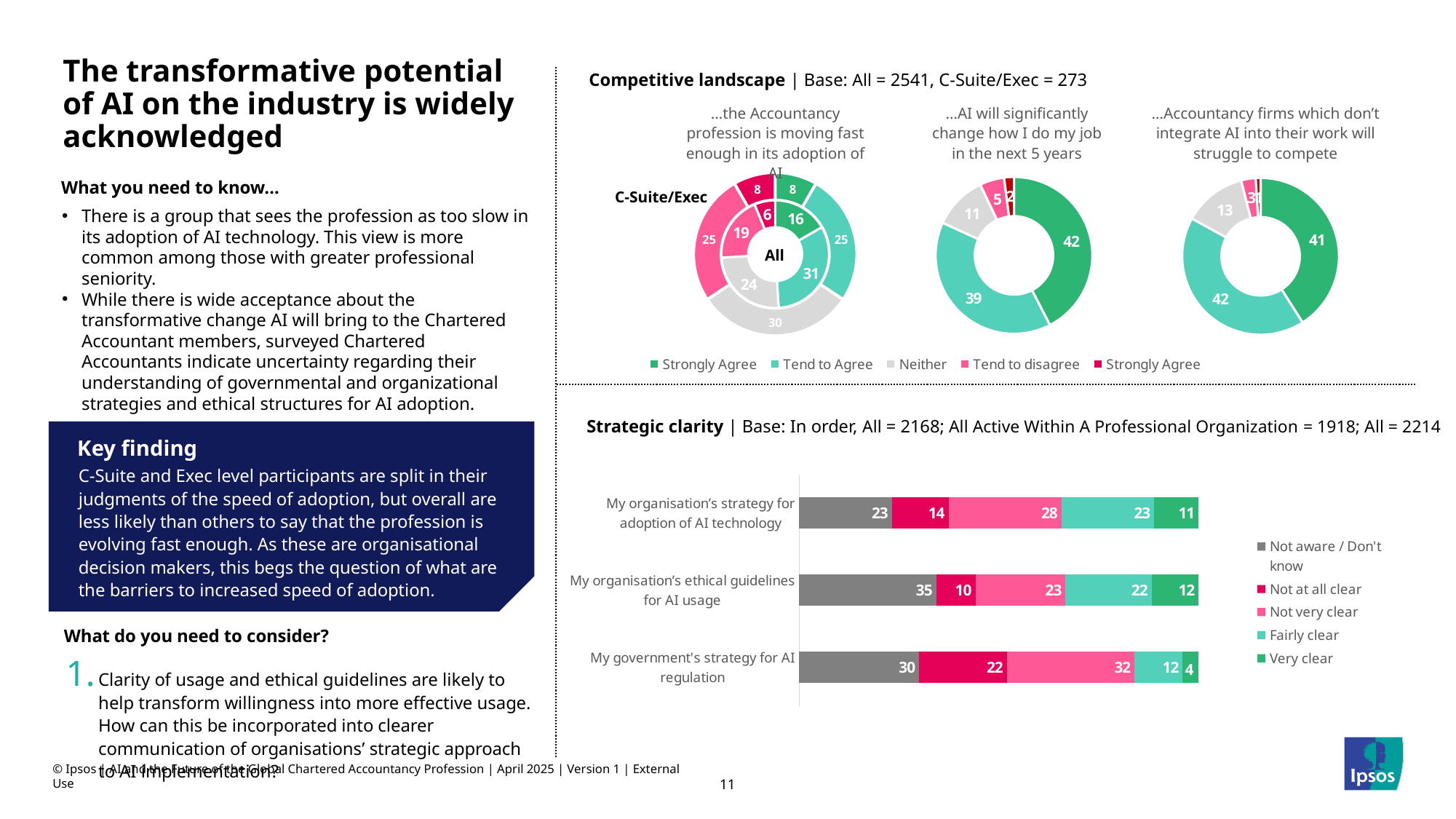
In the Competitive landscape donut '...the Accountancy profession is moving fast enough in its adoption of AI', what is the difference between the Strongly Agree values for All and C-Suite/Exec? 8 In the Strategic clarity chart, which statement has the highest 'Not at all clear' value? My government's strategy for AI regulation How many series does the legend of the Strategic clarity chart list? 5 What kind of chart is the Strategic clarity chart? Stacked bar chart In the Strategic clarity chart, which statement has the lowest 'Very clear' value? My government's strategy for AI regulation In the Strategic clarity chart, what is the total of the segments in the bar for 'My organisation's strategy for adoption of AI technology'? 99 In the Competitive landscape donut '...the Accountancy profession is moving fast enough in its adoption of AI', what is the Neither value for C-Suite/Exec? 30 In the Competitive landscape donut '...the Accountancy profession is moving fast enough in its adoption of AI', which group has the higher Tend to disagree value, All or C-Suite/Exec? C-Suite/Exec In the Competitive landscape donut '...the Accountancy profession is moving fast enough in its adoption of AI', what is the Tend to Agree value for All? 31 In the Competitive landscape donut '...AI will significantly change how I do my job in the next 5 years', what is the Strongly Agree value? 42 In the Competitive landscape donut '...Accountancy firms which don't integrate AI into their work will struggle to compete', what is the Tend to Agree value? 42 In the Strategic clarity chart, what is the 'Not aware / Don't know' value for 'My organisation's ethical guidelines for AI usage'? 35